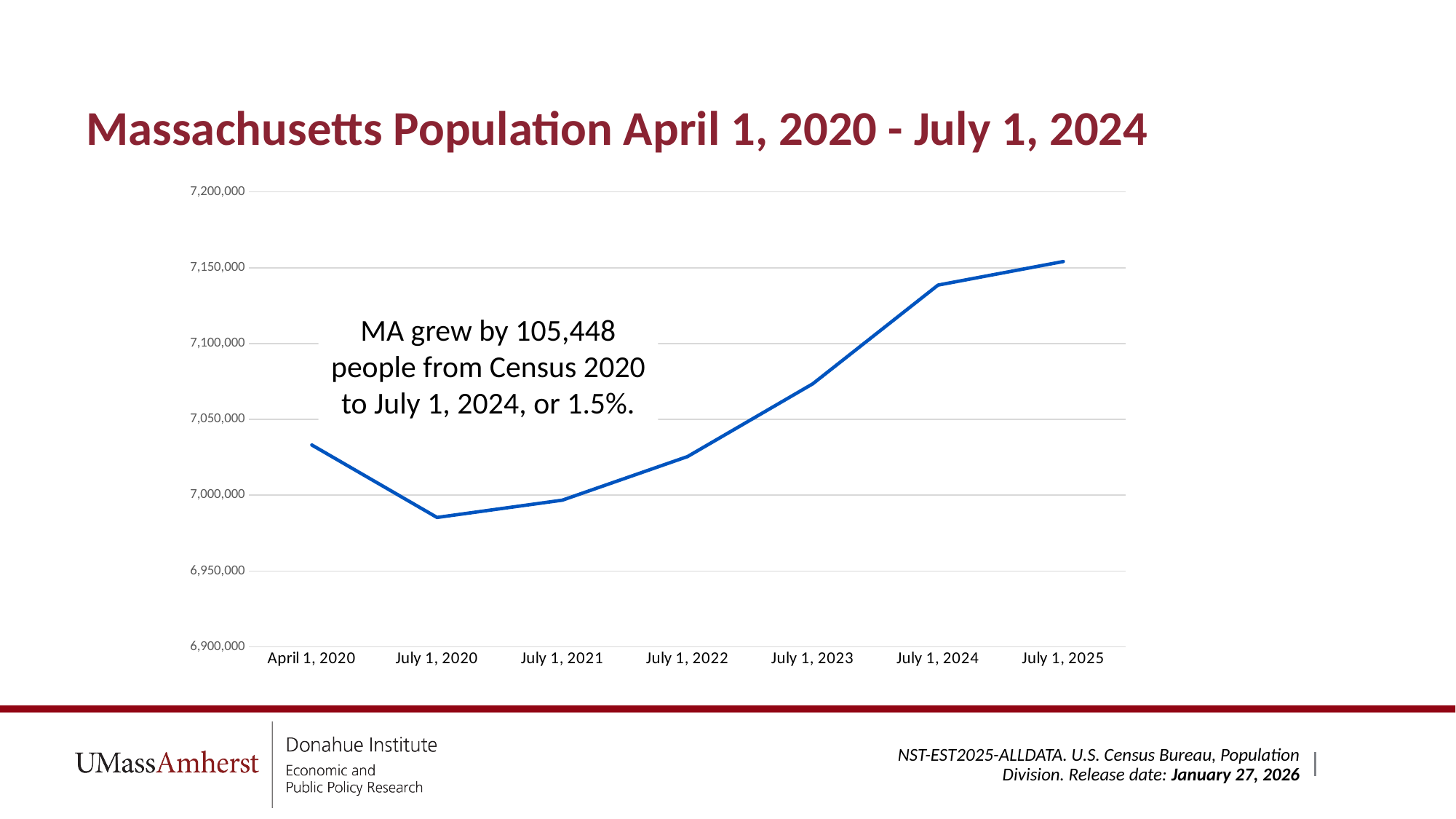
Is the value for July 1, 2023 greater or less than 7,050,000? greater What kind of chart is shown on the slide? line chart Which date has the lowest population value? July 1, 2020 Is the value for July 1, 2024 greater or less than 7,150,000? less How many dates are plotted along the x axis? 7 Do the values rise or fall from July 1, 2020 to July 1, 2025? rise Is the value for July 1, 2020 greater or less than 7,000,000? less Which date has the highest population value? July 1, 2025 According to the annotation on the chart, by how many people did MA grow from Census 2020 to July 1, 2024? 105,448 What is the title of the chart? Massachusetts Population April 1, 2020 - July 1, 2024 Which is larger, the value for April 1, 2020 or the value for July 1, 2021? April 1, 2020